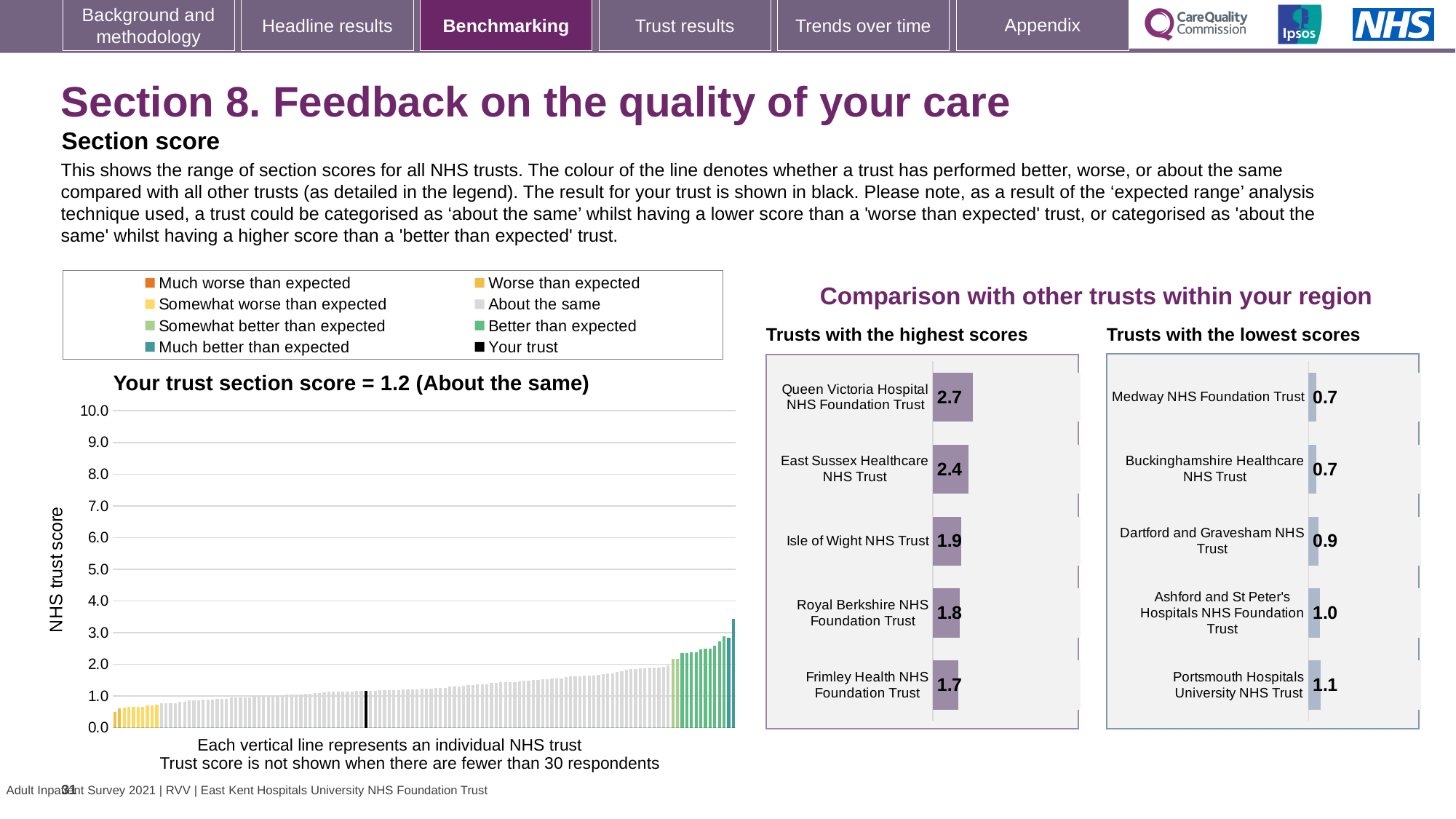
In the 'Trusts with the lowest scores' chart, what is the score for Portsmouth Hospitals University NHS Trust? 1.1 In the 'Trusts with the lowest scores' chart, what is the score for Dartford and Gravesham NHS Trust? 0.9 In the 'Trusts with the lowest scores' chart, which trust has the highest score shown? Portsmouth Hospitals University NHS Trust According to the title of the main chart on the left, what is your trust's section score? 1.2 How many trusts are listed in the 'Trusts with the lowest scores' chart? 5 In the 'Trusts with the highest scores' chart, what is the score for Isle of Wight NHS Trust? 1.9 In the 'Trusts with the highest scores' chart, which has the larger score: East Sussex Healthcare NHS Trust or Royal Berkshire NHS Foundation Trust? East Sussex Healthcare NHS Trust In the 'Trusts with the highest scores' chart, which trust has the lowest score shown? Frimley Health NHS Foundation Trust In the 'Trusts with the highest scores' chart, what is the score for Queen Victoria Hospital NHS Foundation Trust? 2.7 In the main chart on the left, do the trust scores rise or fall from left to right along the x axis? rise In the 'Trusts with the highest scores' chart, what is the difference between the scores of Queen Victoria Hospital NHS Foundation Trust and Frimley Health NHS Foundation Trust? 1.0 How many entries does the legend of the main chart on the left list? 8